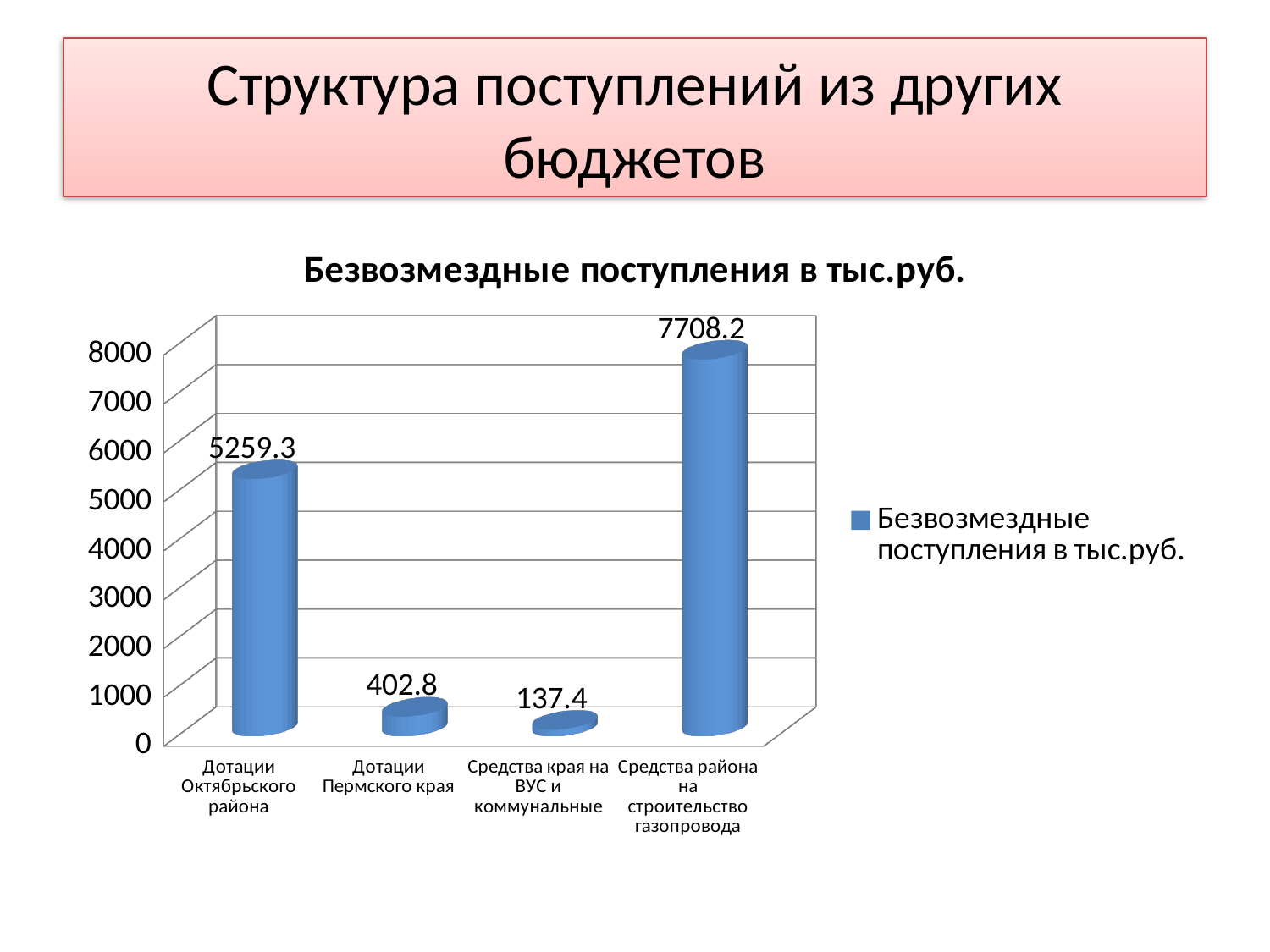
What is the value for Средства района на строительство газопровода? 7708.2 What is the value for Дотации Пермского края? 402.8 What is the title of the chart? Безвозмездные поступления в тыс.руб. What is the value for Дотации Октябрьского района? 5259.3 How many categories are shown on the x axis? 4 What is the difference between the values for Средства района на строительство газопровода and Дотации Октябрьского района? 2448.9 How many series does the legend list? 1 What is the value for Средства края на ВУС и коммунальные? 137.4 What kind of chart is shown? bar chart Which is larger: the value for Дотации Пермского края or the value for Средства края на ВУС и коммунальные? Дотации Пермского края Which category has the lowest value? Средства края на ВУС и коммунальные Which category has the highest value? Средства района на строительство газопровода